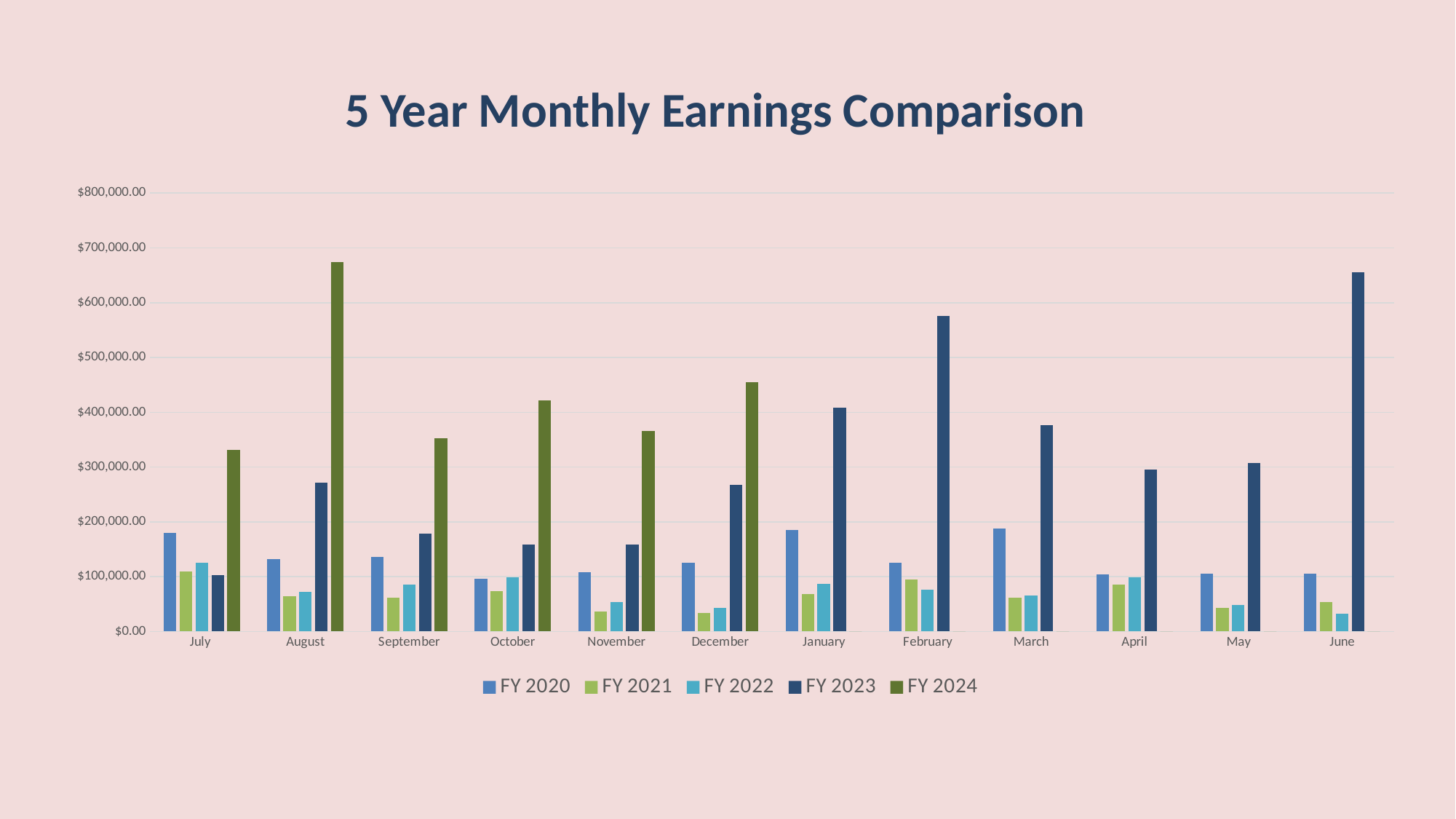
How many months are shown on the x axis? 12 Is the FY 2024 value for August greater or less than $600,000.00? greater Is the FY 2023 value for February greater or less than $500,000.00? greater Is the FY 2024 value for December greater or less than $400,000.00? greater What kind of chart is shown on the slide? bar chart Which is larger in July: the FY 2020 value or the FY 2023 value? FY 2020 What is the title of the chart? 5 Year Monthly Earnings Comparison In which month is the FY 2023 value highest? June In which month is the FY 2024 value highest? August How many series does the legend list? 5